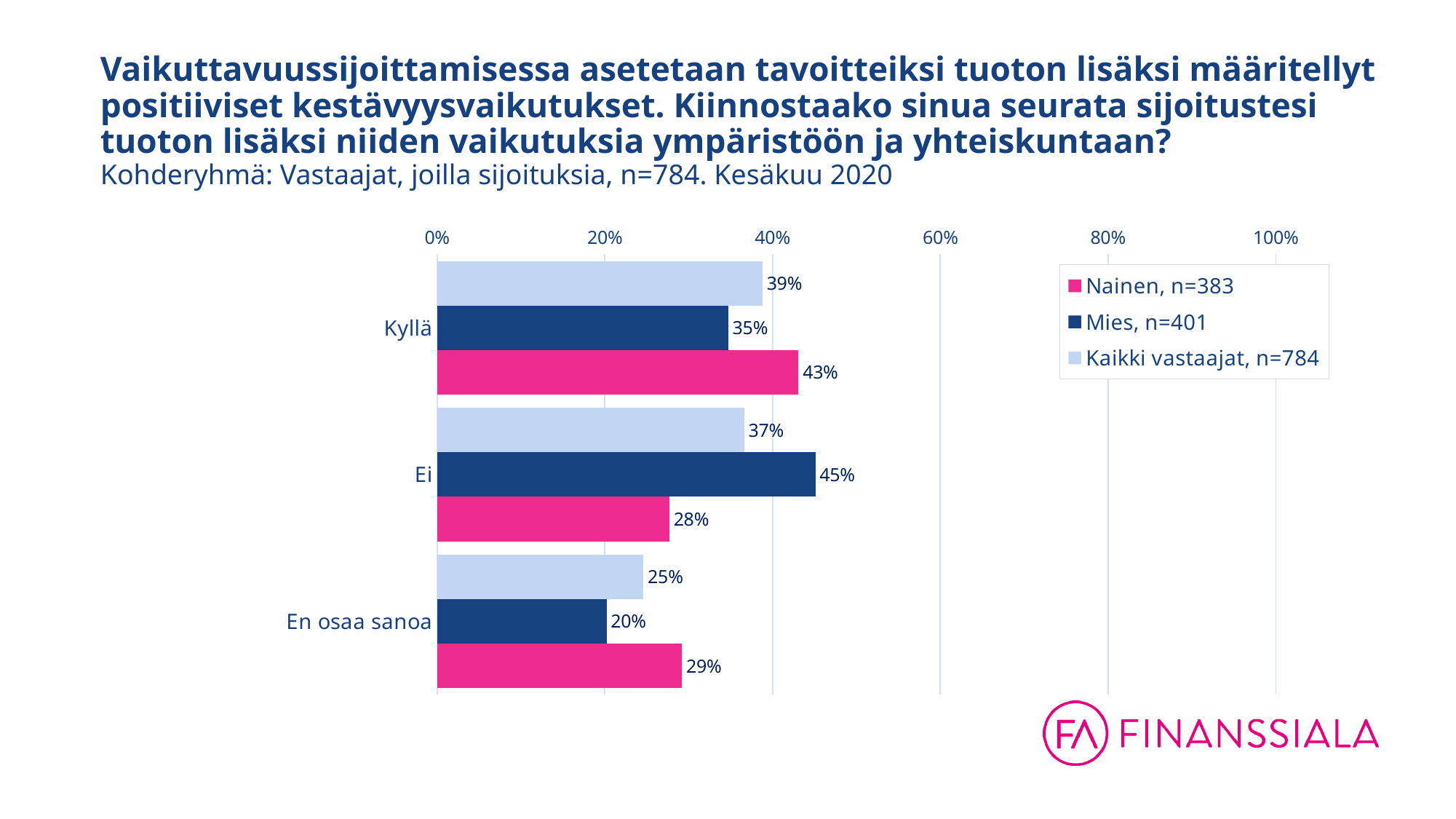
What is the value for Nainen, n=383 in the Kyllä category? 43% What is the value for Kaikki vastaajat, n=784 in the En osaa sanoa category? 25% What colour are the bars for the Nainen, n=383 series? pink Which category has the lowest value for the Nainen, n=383 series? Ei What kind of chart is shown on the slide? bar chart How many series does the legend list? 3 In the Kyllä category, which is larger: the value for Nainen, n=383 or the value for Mies, n=401? Nainen, n=383 What is the value for Mies, n=401 in the Ei category? 45% What is the difference between the Mies, n=401 and Nainen, n=383 values in the Ei category? 17% Is the value for Mies, n=401 in the En osaa sanoa category greater or less than 40%? less How many categories are shown on the chart? 3 Which category has the highest value for the Mies, n=401 series? Ei